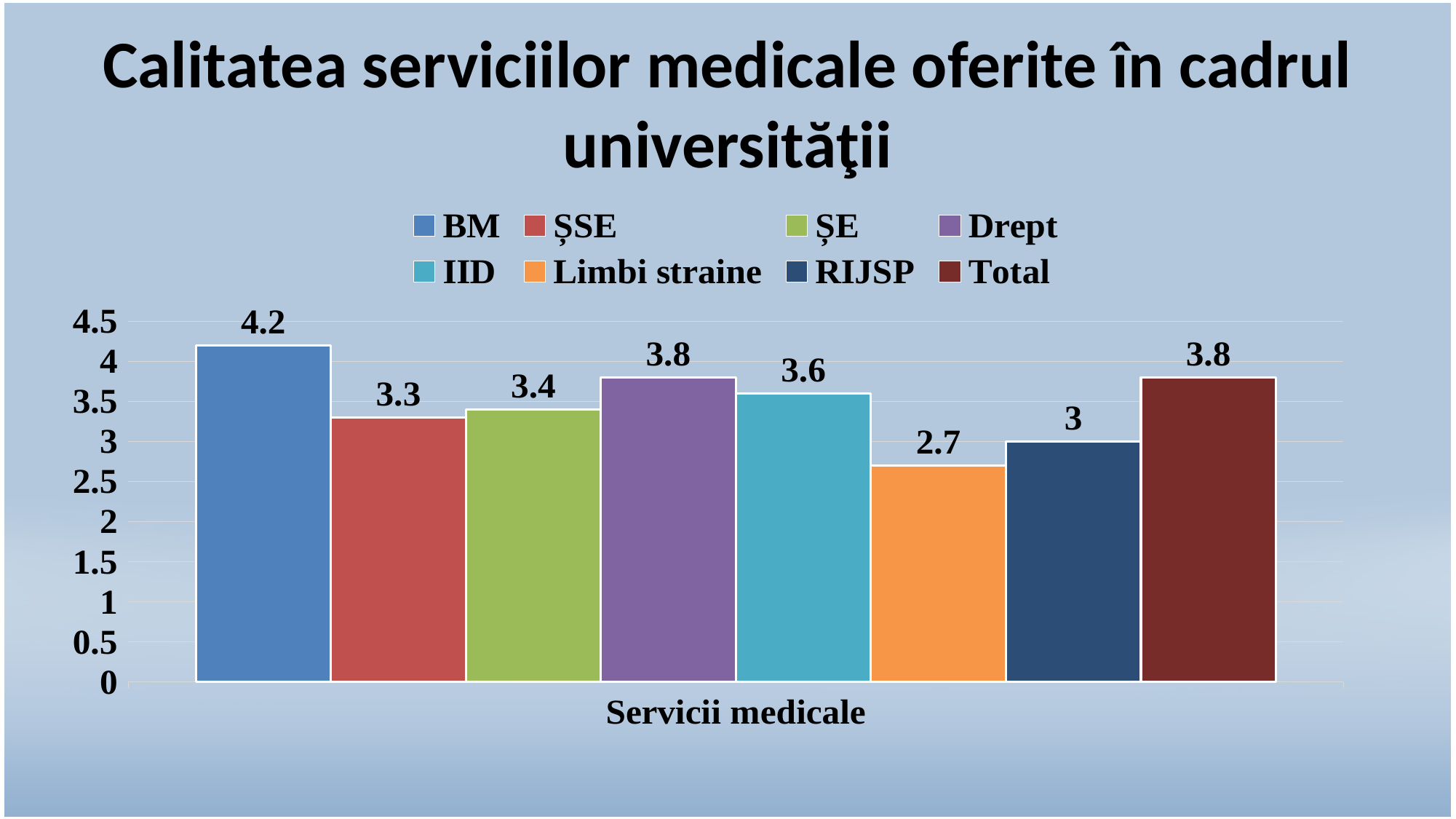
Which is larger, the value for IID or the value for ȘE? IID Is the value for Drept greater or less than 3.5? greater What kind of chart is shown on the slide? bar chart What is the value for BM? 4.2 What is the value for RIJSP? 3 What is the difference between the values for BM and ȘSE? 0.9 What is the value for Total? 3.8 What is the value for Limbi straine? 2.7 What is the label on the x axis of the chart? Servicii medicale How many series does the legend list? 8 Which series has the lowest value? Limbi straine Which series has the highest value? BM